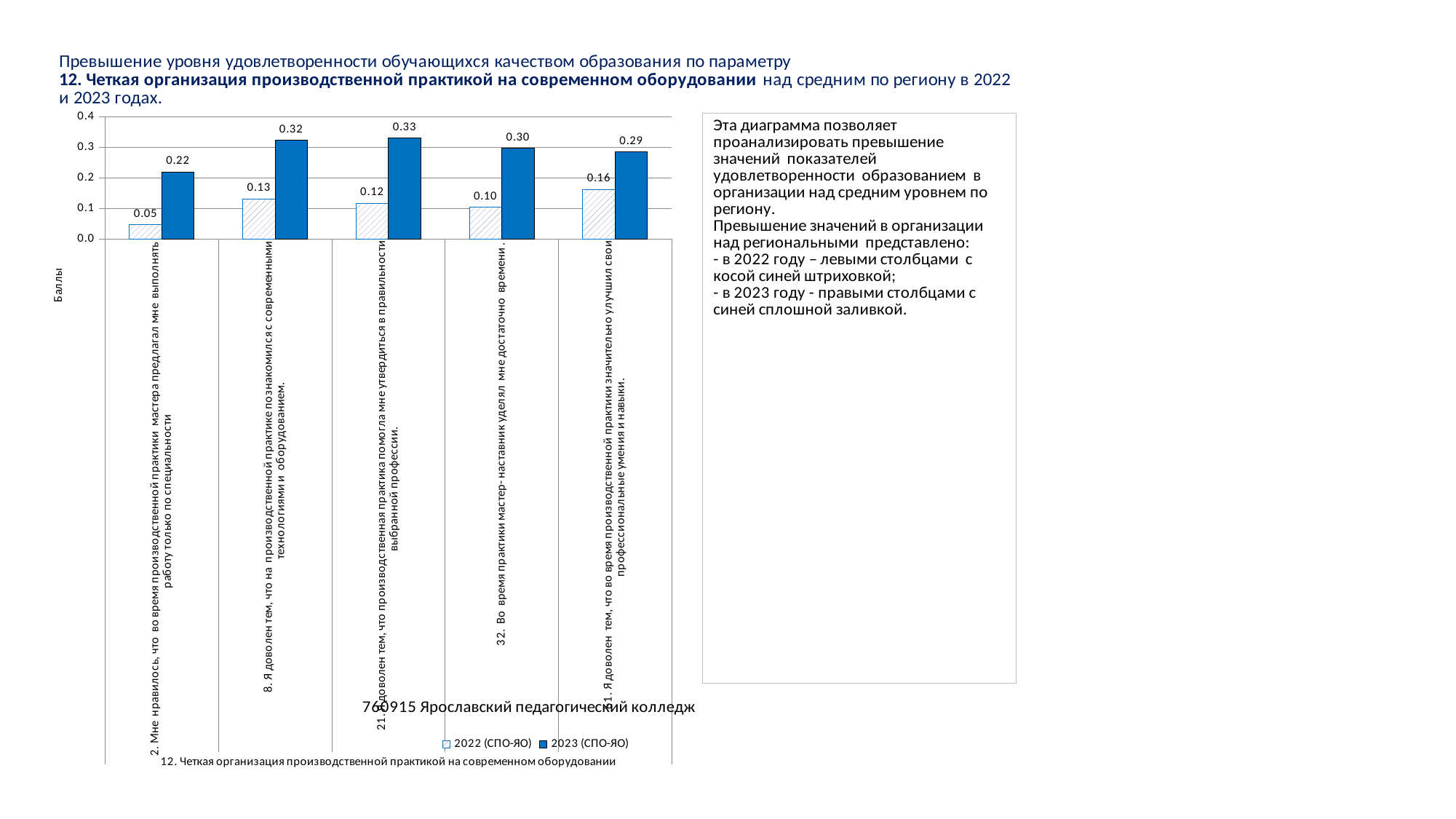
Which category has the lowest 2022 (СПО-ЯО) value? 2 (Мне нравилось, что во время производственной практики мастер предлагал мне выполнять работу только по специальности) What is the 2022 (СПО-ЯО) value for category 32 (Во время практики мастер-наставник уделял мне достаточно времени)? 0.10 Which category has the highest 2023 (СПО-ЯО) value? 21 (производственная практика помогла мне утвердиться в правильности выбранной профессии) How many series does the chart legend list? 2 Which is larger for category 32: the 2022 (СПО-ЯО) value or the 2023 (СПО-ЯО) value? 2023 (СПО-ЯО) What is the label of the y axis of the chart? Баллы What is the 2023 (СПО-ЯО) value for category 8 (Я доволен тем, что на производственной практике познакомился с современными технологиями и оборудованием)? 0.32 What is the 2022 (СПО-ЯО) value for category 2 (Мне нравилось, что во время производственной практики мастер предлагал мне выполнять работу только по специальности)? 0.05 What kind of chart is shown on the slide? bar chart How many categories are shown on the x axis of the chart? 5 Is the 2023 (СПО-ЯО) value for category 2 greater or less than 0.3? less